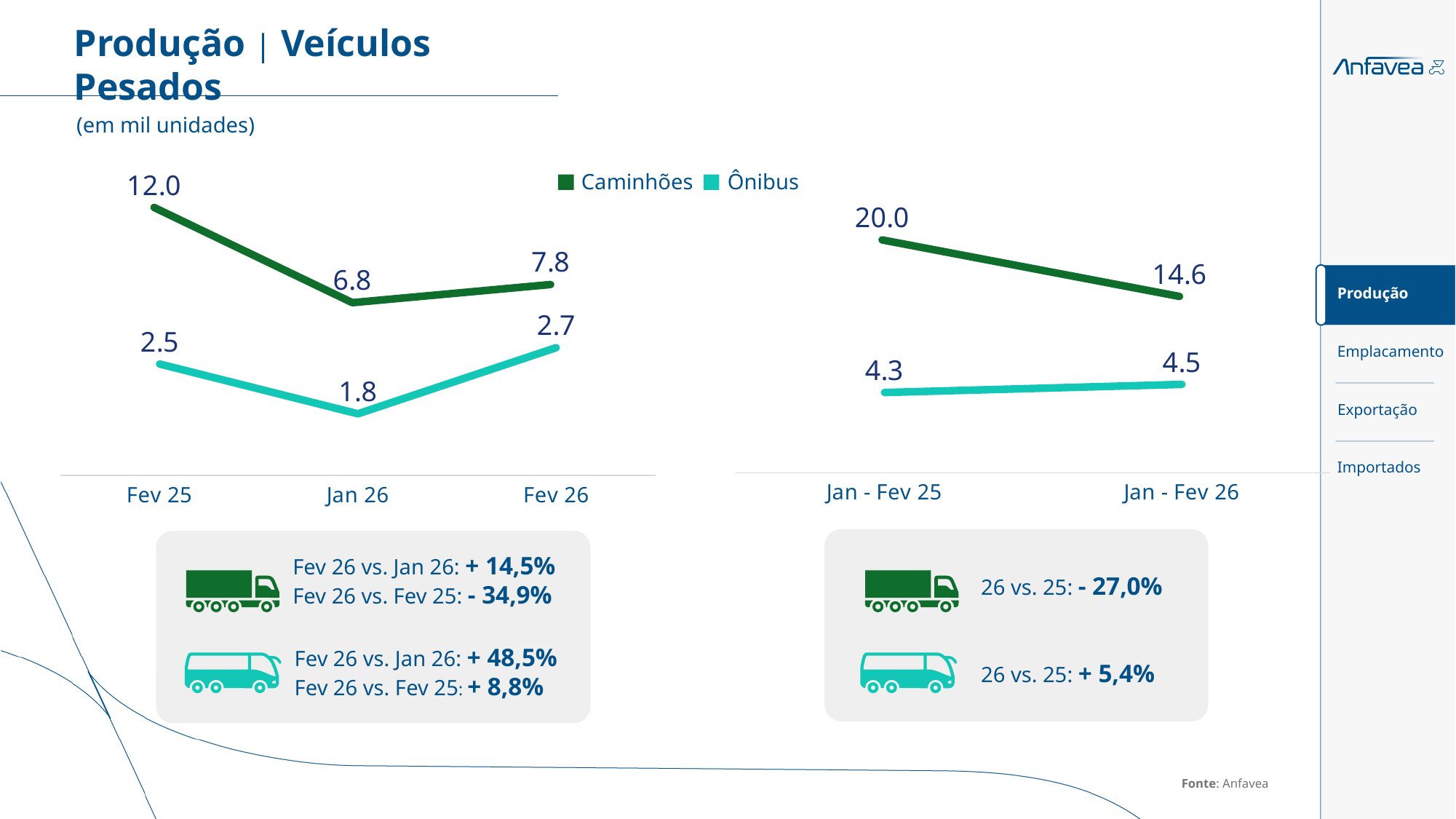
What type of chart is used on this slide? Line chart In the left chart (Fev 25 to Fev 26), what is the difference between the Caminhões values for Fev 25 and Fev 26? 4.2 In the left chart (Fev 25 to Fev 26), what is the value for Caminhões in Jan 26? 6.8 In the left chart (Fev 25 to Fev 26), which period has the highest value for Caminhões? Fev 25 How many periods are shown on the x axis of the left chart (Fev 25 to Fev 26)? 3 In the right chart (Jan - Fev 25 vs Jan - Fev 26), is the Ônibus value higher in Jan - Fev 25 or Jan - Fev 26? Jan - Fev 26 In the right chart (Jan - Fev 25 vs Jan - Fev 26), what is the value for Caminhões in Jan - Fev 26? 14.6 How many series does the legend list? 2 In the right chart (Jan - Fev 25 vs Jan - Fev 26), what is the value for Ônibus in Jan - Fev 25? 4.3 In the left chart (Fev 25 to Fev 26), which period has the lowest value for Ônibus? Jan 26 In the right chart (Jan - Fev 25 vs Jan - Fev 26), what is the difference between the Caminhões values for Jan - Fev 25 and Jan - Fev 26? 5.4 In the left chart (Fev 25 to Fev 26), what is the value for Ônibus in Fev 26? 2.7